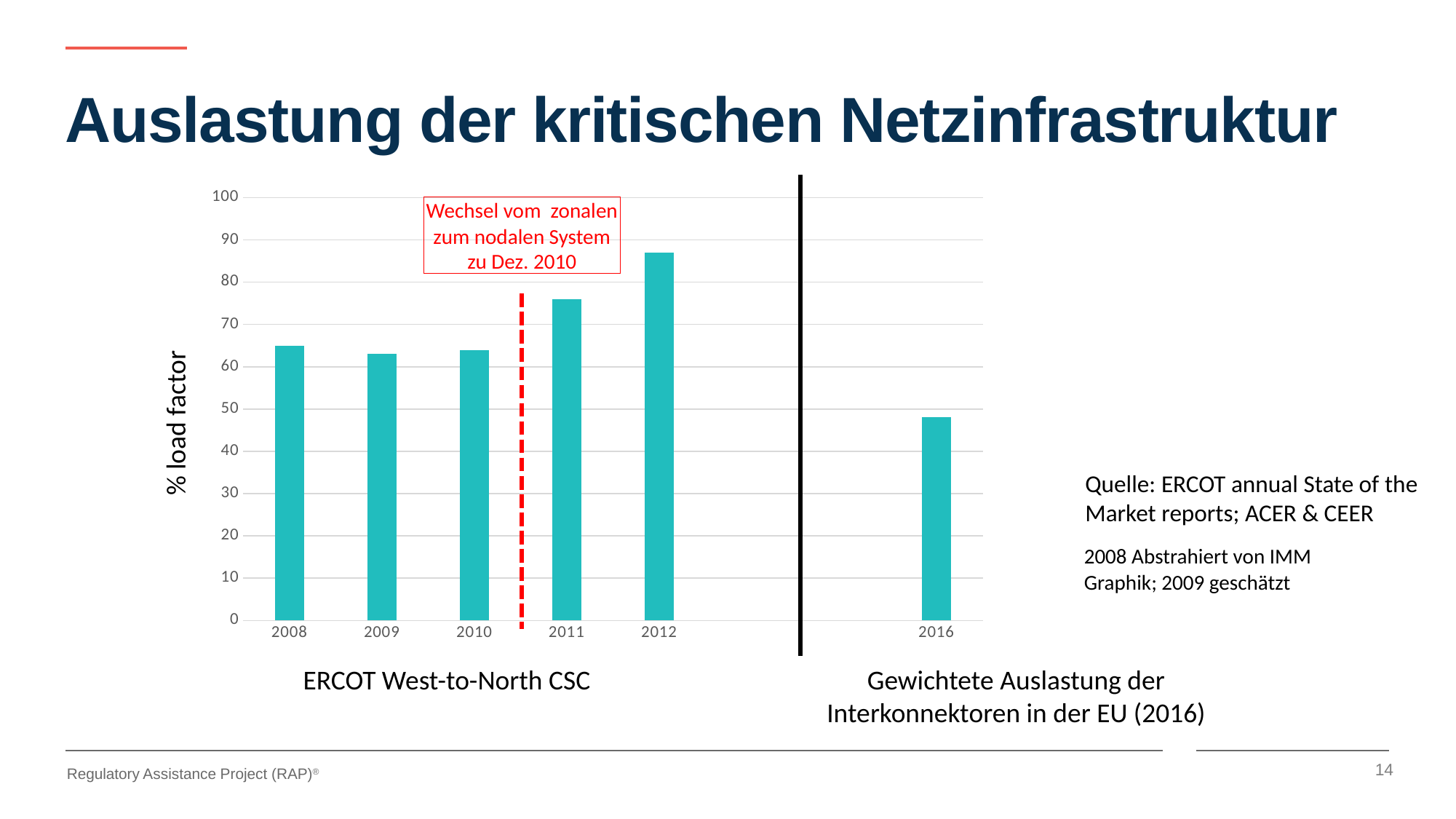
Is the value for 2010 greater or less than 70? less Which year has the highest % load factor? 2012 Which is larger, the value for 2011 or the value for 2008? 2011 Do the values rise or fall from 2010 to 2012? rise Which year has the lowest % load factor? 2016 Is the value for 2012 greater or less than 80? greater Is the value for 2011 greater or less than 70? greater What is the label on the vertical axis? % load factor What kind of chart is shown on the slide? bar chart How many bars are plotted in the chart? 6 What does the red annotation box in the chart say? Wechsel vom zonalen zum nodalen System zu Dez. 2010